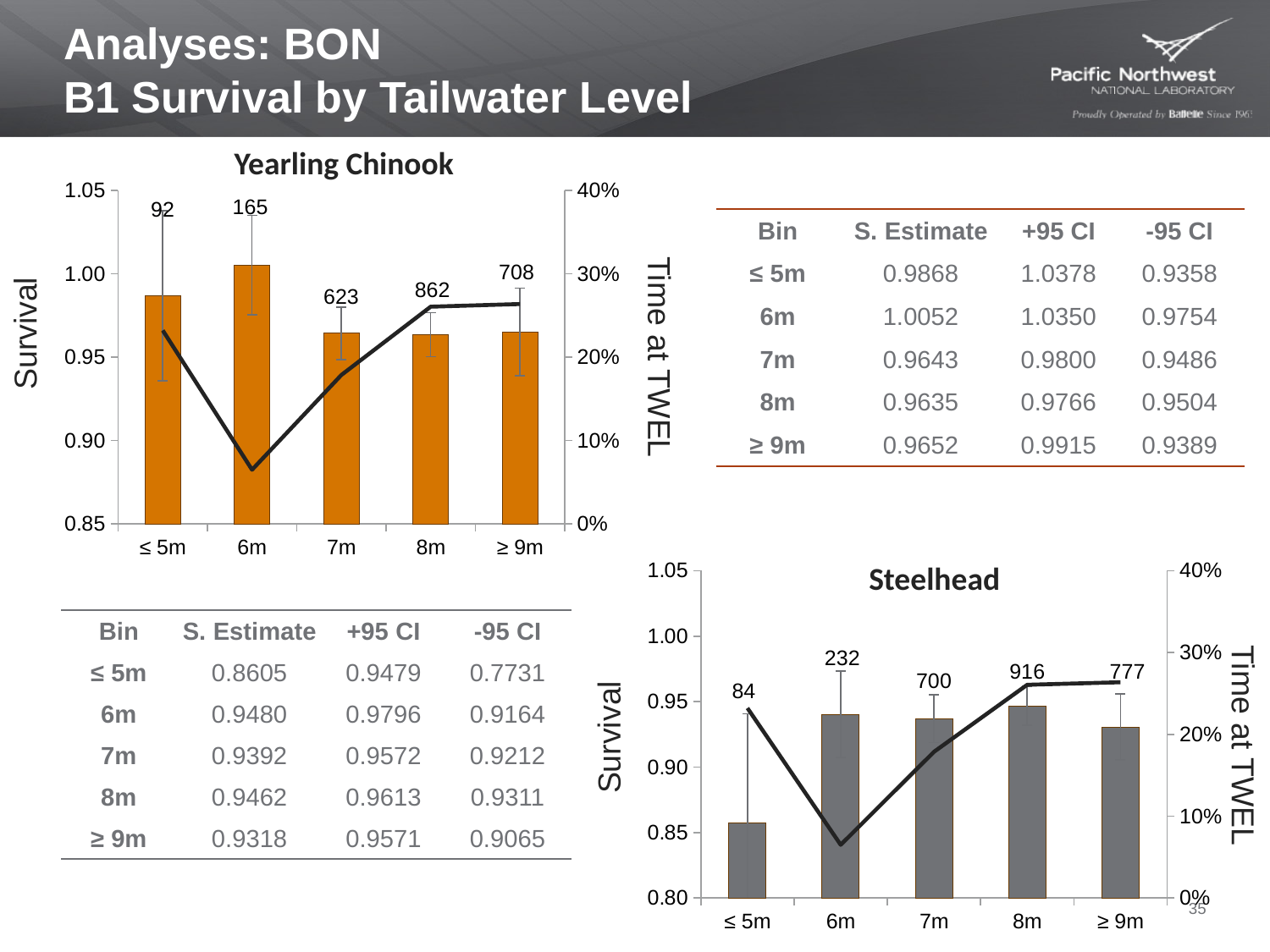
What kind of chart is the Yearling Chinook chart? bar chart with a line In the Yearling Chinook chart, which bin has the smallest printed count label? ≤ 5m In the Yearling Chinook chart, what number is printed above the 7m bar? 623 In the Steelhead chart, which survival bar is taller, ≤ 5m or 6m? 6m In the Yearling Chinook chart, which bin has the largest printed count label? 8m How many tailwater level bins are shown on the x axis of the Yearling Chinook chart? 5 In the Yearling Chinook chart, what is the difference between the count labels for 8m and 7m? 239 In the Steelhead chart, is the survival bar for ≤ 5m greater or less than 0.90? less In the Yearling Chinook chart, is the survival bar for ≤ 5m greater or less than 0.95? greater In the Steelhead chart, which bin has the largest printed count label? 8m In the Steelhead chart, what number is printed above the 6m bar? 232 What is the label of the right-hand vertical axis on the Steelhead chart? Time at TWEL